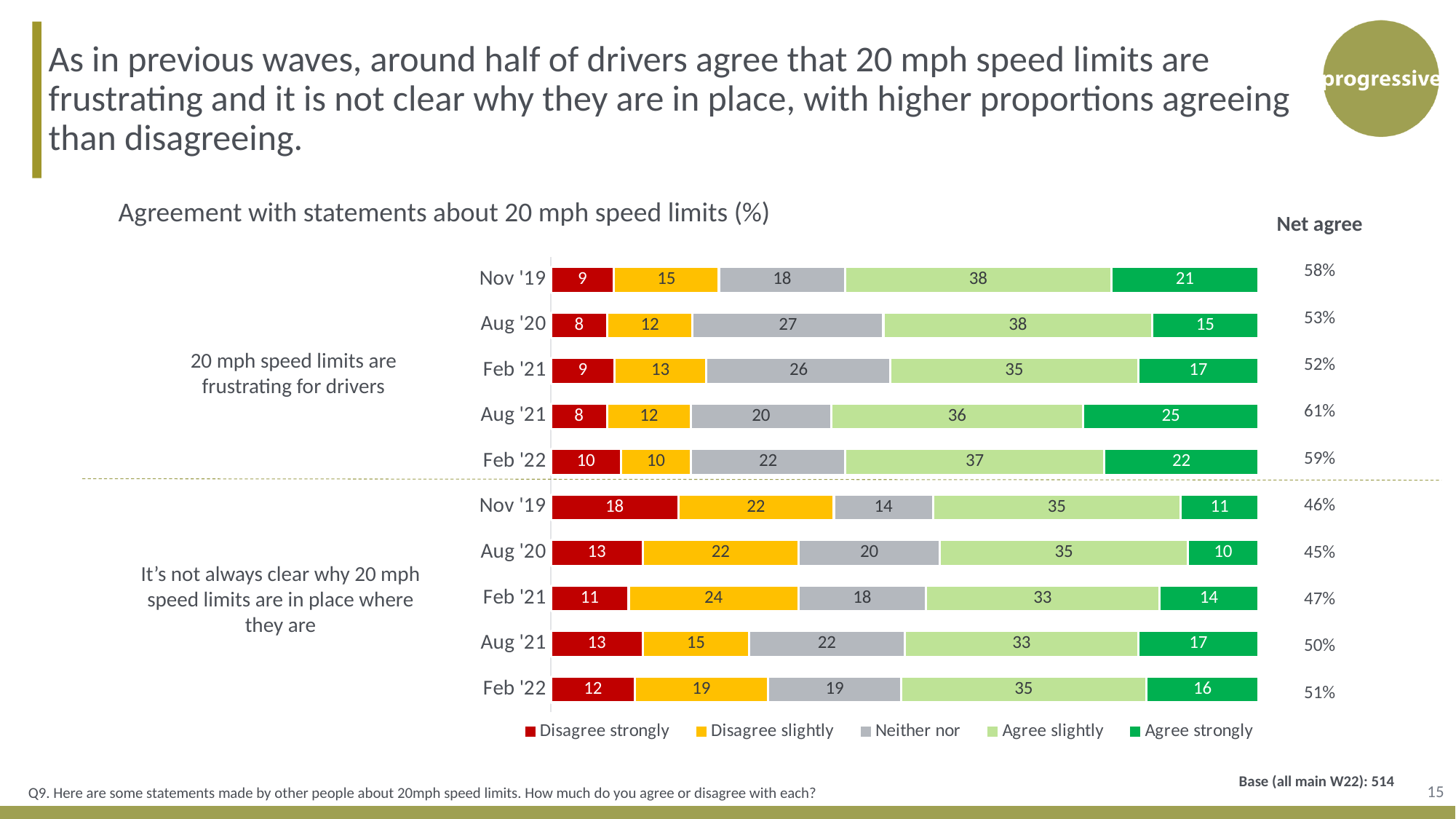
What is the net agree figure for '20 mph speed limits are frustrating for drivers' in Feb '22? 59% For 'It's not always clear why 20 mph speed limits are in place where they are', what is the difference between the 'Disagree slightly' values in Feb '21 and Aug '21? 9 Which wave has the highest net agree for '20 mph speed limits are frustrating for drivers'? Aug '21 How many survey waves are shown for each statement? 5 What kind of chart is shown on the slide? Stacked bar chart What percentage of drivers agree strongly that 20 mph speed limits are frustrating for drivers in Aug '21? 25 What is the total of the Nov '19 bar for '20 mph speed limits are frustrating for drivers'? 101 What is the 'Disagree strongly' value for 'It's not always clear why 20 mph speed limits are in place where they are' in Nov '19? 18 For the Feb '22 wave, is the 'Agree strongly' value larger for '20 mph speed limits are frustrating for drivers' or for 'It's not always clear why 20 mph speed limits are in place where they are'? 20 mph speed limits are frustrating for drivers What is the 'Neither nor' value for the statement '20 mph speed limits are frustrating for drivers' in Aug '20? 27 How many series does the legend list? 5 Which wave has the lowest net agree for 'It's not always clear why 20 mph speed limits are in place where they are'? Aug '20